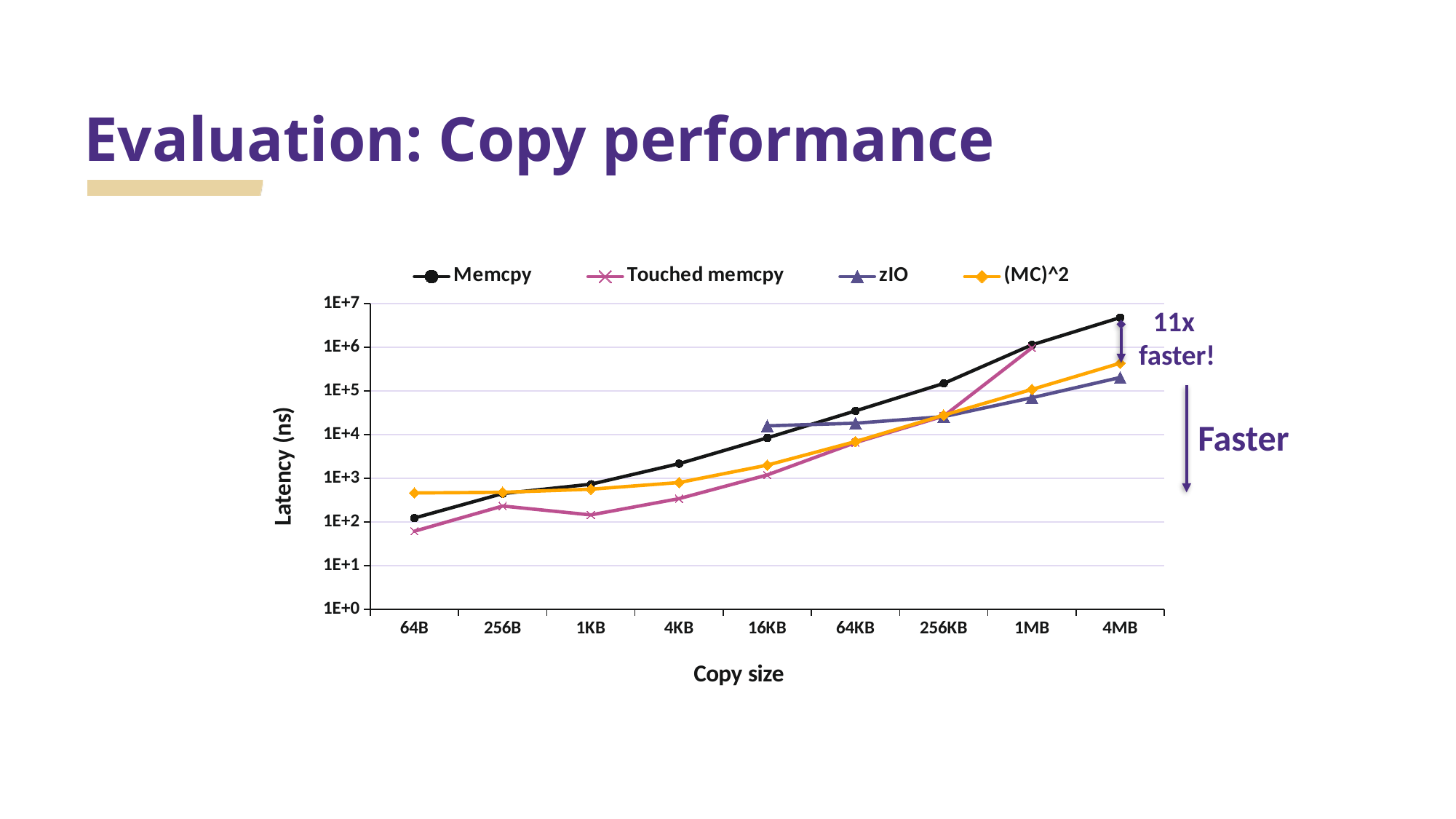
Is the Touched memcpy latency at 64B greater or less than 1E+2? less Is the (MC)^2 latency at 64B greater or less than 1E+3? less Does the Memcpy latency rise or fall as copy size increases along the x axis? rise Is the Memcpy latency at 4MB greater or less than 1E+6? greater What is the label of the y axis? Latency (ns) What kind of chart is shown on the slide? line chart How many copy sizes are plotted along the x axis? 9 How many series does the legend list? 4 Which series has the highest latency at 4MB? Memcpy Which series has the lowest latency at 4MB? zIO At 64B, which has the higher latency: Memcpy or Touched memcpy? Memcpy